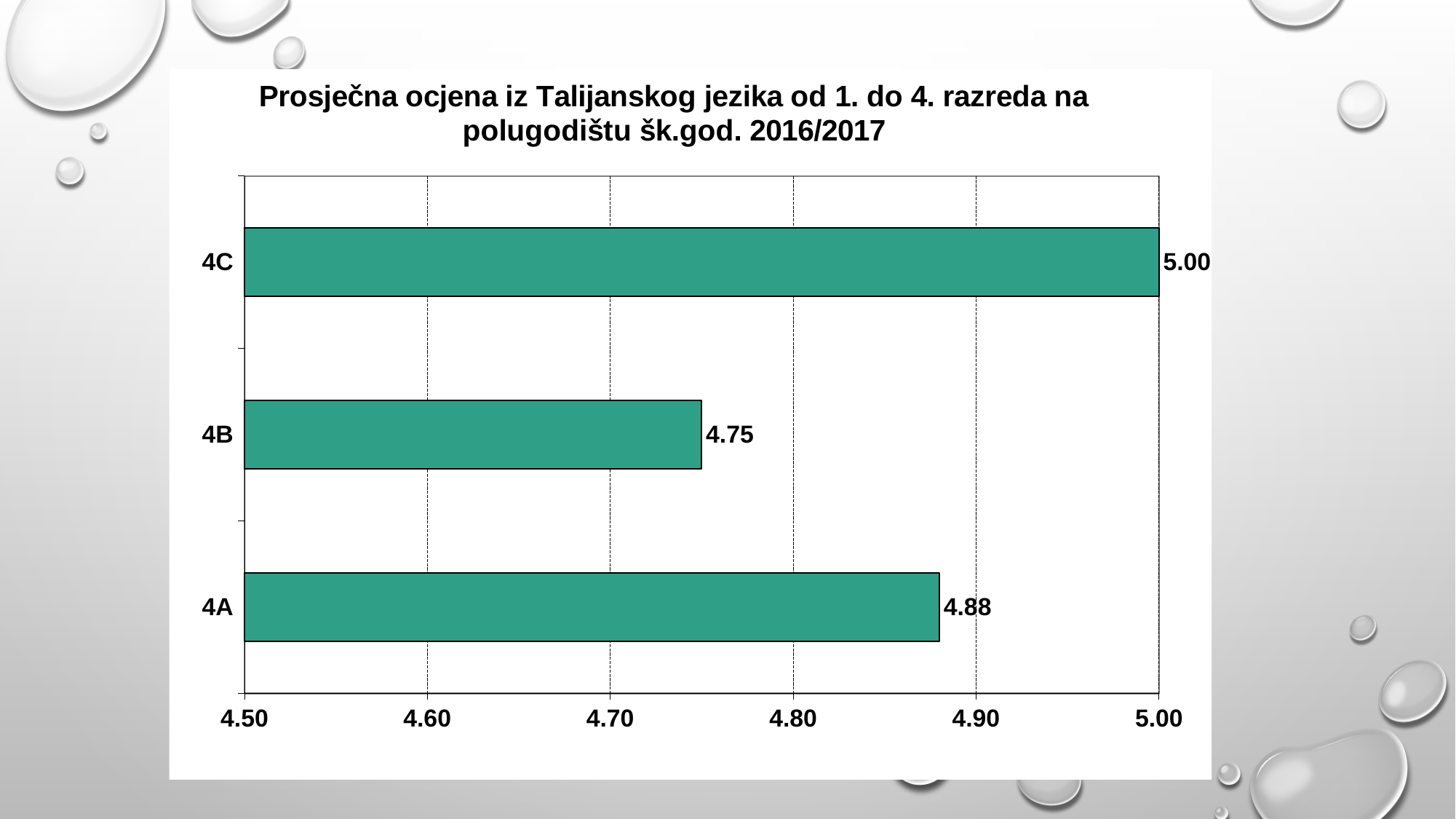
How many classes are shown in the chart? 3 Which class has the lowest average grade? 4B Which class has the highest average grade? 4C What is the average grade for class 4C? 5.00 What is the average grade for class 4B? 4.75 What is the title of the chart? Prosječna ocjena iz Talijanskog jezika od 1. do 4. razreda na polugodištu šk.god. 2016/2017 Is the value for 4A greater or less than 4.80? greater What kind of chart is shown on the slide? Bar chart Which class has a higher average grade, 4A or 4B? 4A What is the difference between the average grades of 4A and 4B? 0.13 What is the average grade for class 4A? 4.88 What is the difference between the average grades of 4C and 4B? 0.25